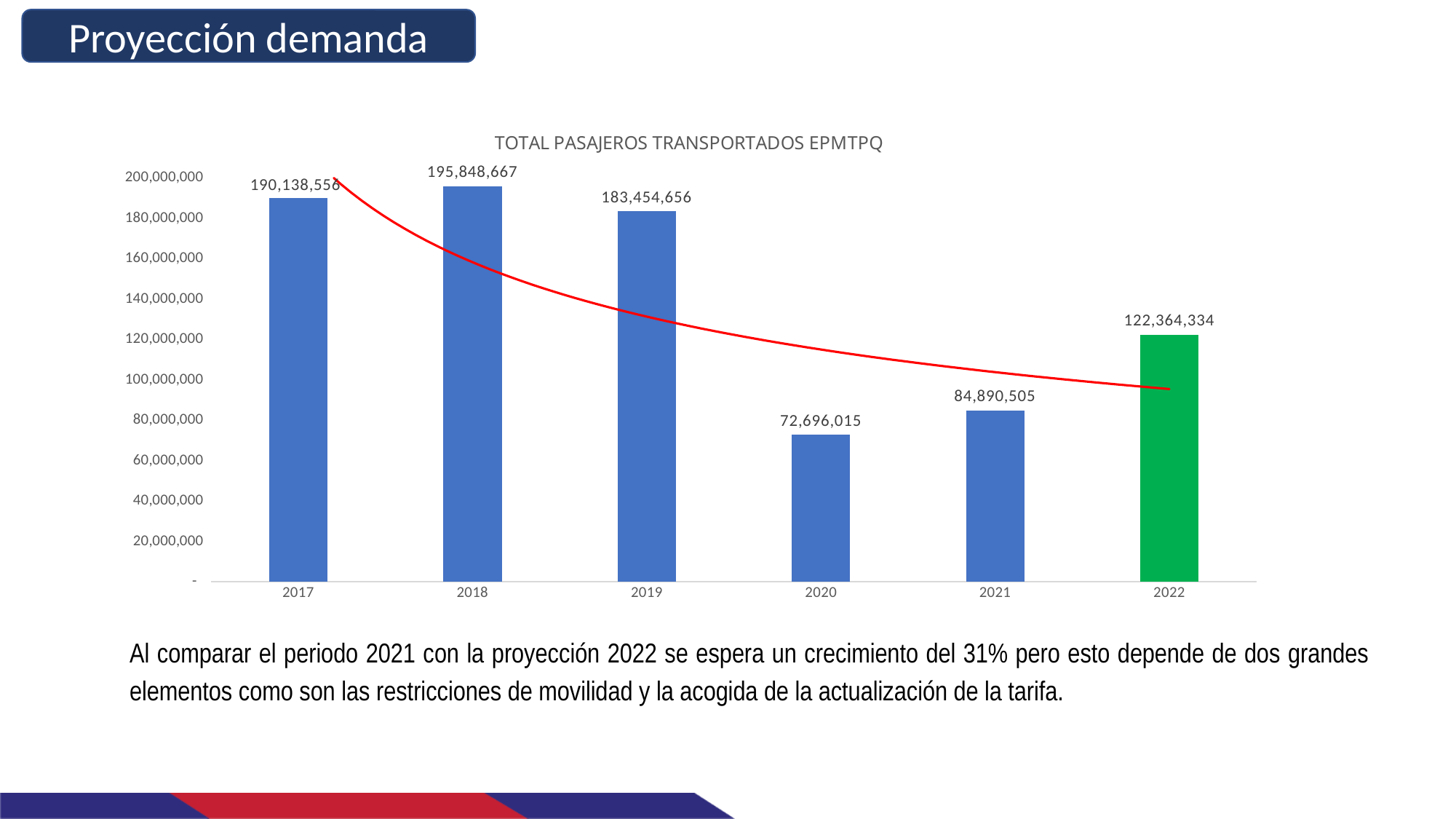
What is the difference between the values for 2018 and 2019? 12,394,011 What kind of chart is shown on the slide? Bar chart What is the value for 2020? 72,696,015 Which bar is coloured green instead of blue? 2022 Which year has the highest value? 2018 What is the value for 2022? 122,364,334 What is the difference between the values for 2022 and 2021? 37,473,829 What is the title of the chart? TOTAL PASAJEROS TRANSPORTADOS EPMTPQ Which year has the lowest value? 2020 What is the value for 2018? 195,848,667 Which is larger, the value for 2021 or the value for 2020? 2021 How many years are shown on the x axis of the chart? 6